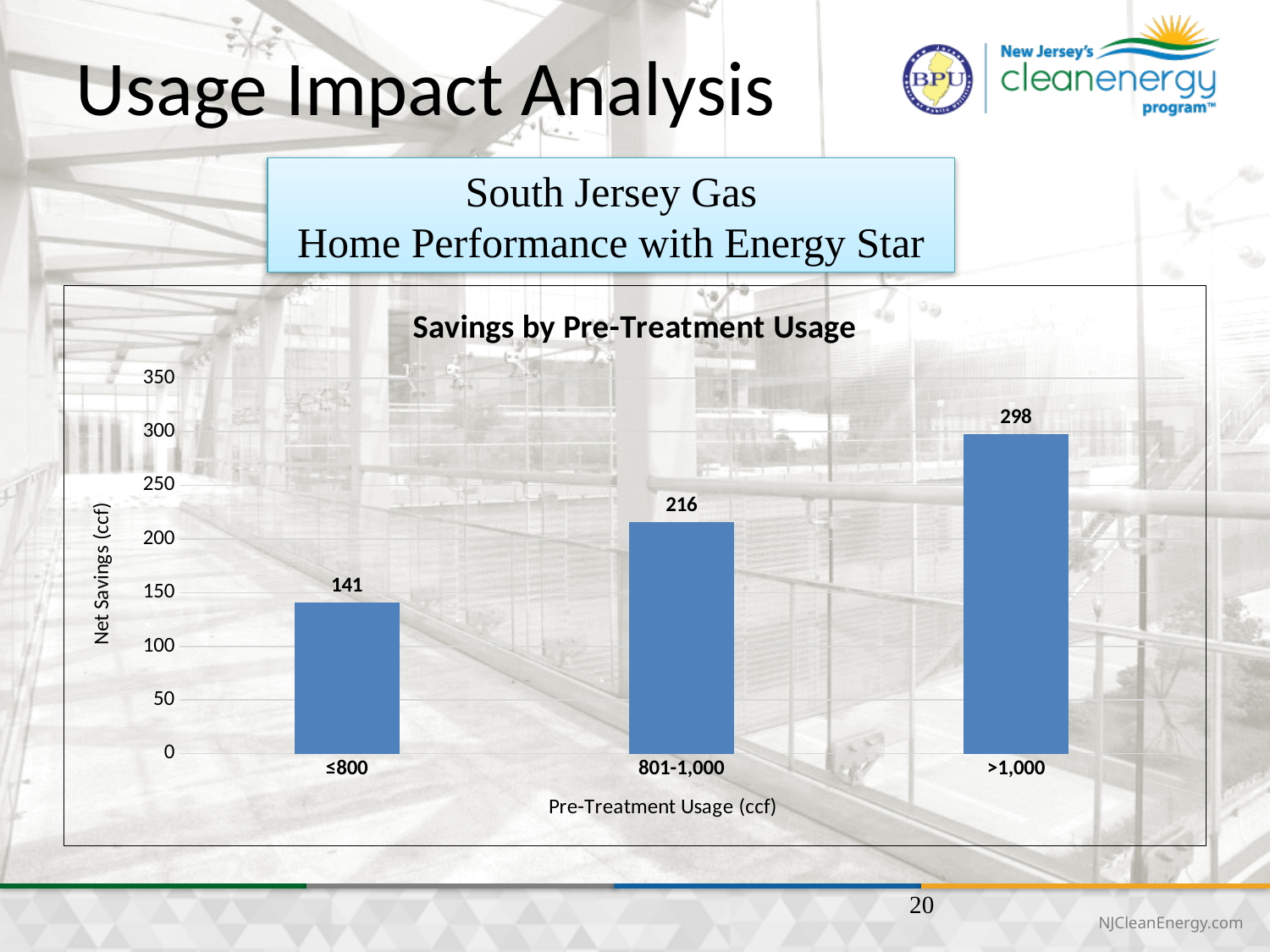
How many pre-treatment usage categories are shown in the chart? 3 Which has larger net savings, the 801-1,000 category or the >1,000 category? >1,000 What is the difference in net savings between the 801-1,000 and ≤800 categories? 75 What is the difference in net savings between the >1,000 and ≤800 categories? 157 What is the net savings value for the ≤800 pre-treatment usage category? 141 Which pre-treatment usage category has the lowest net savings? ≤800 Do net savings rise or fall as pre-treatment usage increases along the x axis? Rise What is the net savings value for the 801-1,000 pre-treatment usage category? 216 Is the net savings value for the 801-1,000 category greater or less than 200? greater Which pre-treatment usage category has the highest net savings? >1,000 What is the net savings value for the >1,000 pre-treatment usage category? 298 What kind of chart is shown on the slide? Bar chart